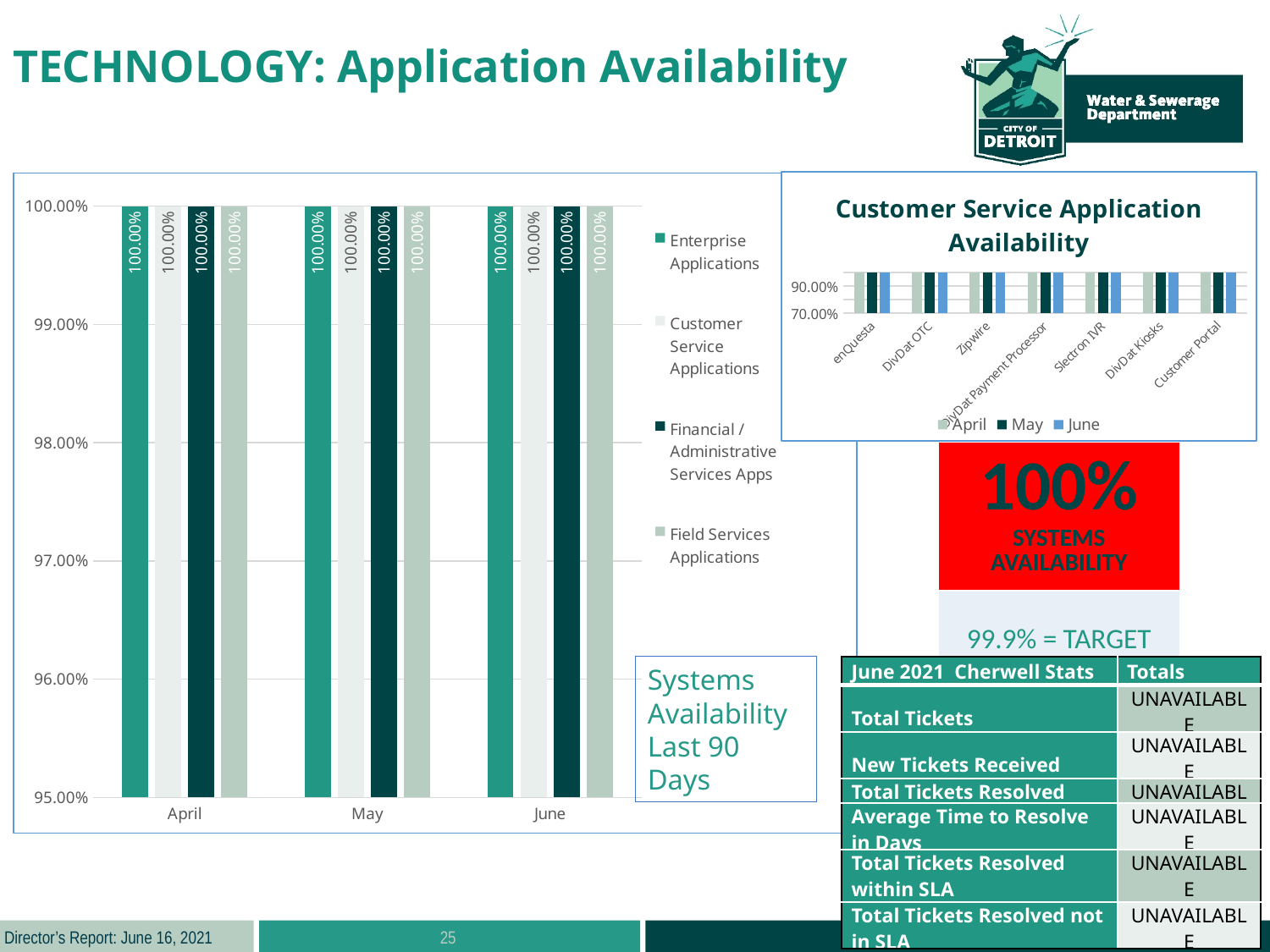
On the Customer Service Application Availability chart, how many series does the legend list? 3 On the Systems Availability Last 90 Days chart, how many months are shown on the x axis? 3 On the Customer Service Application Availability chart, is the value for enQuesta in June greater or less than 90.00%? greater On the Systems Availability Last 90 Days chart, what is the value for Field Services Applications in June? 100.00% On the Systems Availability Last 90 Days chart, what is the value for Financial / Administrative Services Apps in May? 100.00% On the Customer Service Application Availability chart, how many applications are shown on the x axis? 7 On the Systems Availability Last 90 Days chart, do the values for Customer Service Applications rise, fall, or stay the same from April to June? stay the same On the Systems Availability Last 90 Days chart, what is the value for Enterprise Applications in April? 100.00% On the Systems Availability Last 90 Days chart, what is the difference between the Enterprise Applications value in April and the Enterprise Applications value in June? 0.00% On the Systems Availability Last 90 Days chart, how many series does the legend list? 4 What kind of chart is the Systems Availability Last 90 Days chart? bar chart On the Customer Service Application Availability chart, which series is shown in the lightest colour in the legend? April